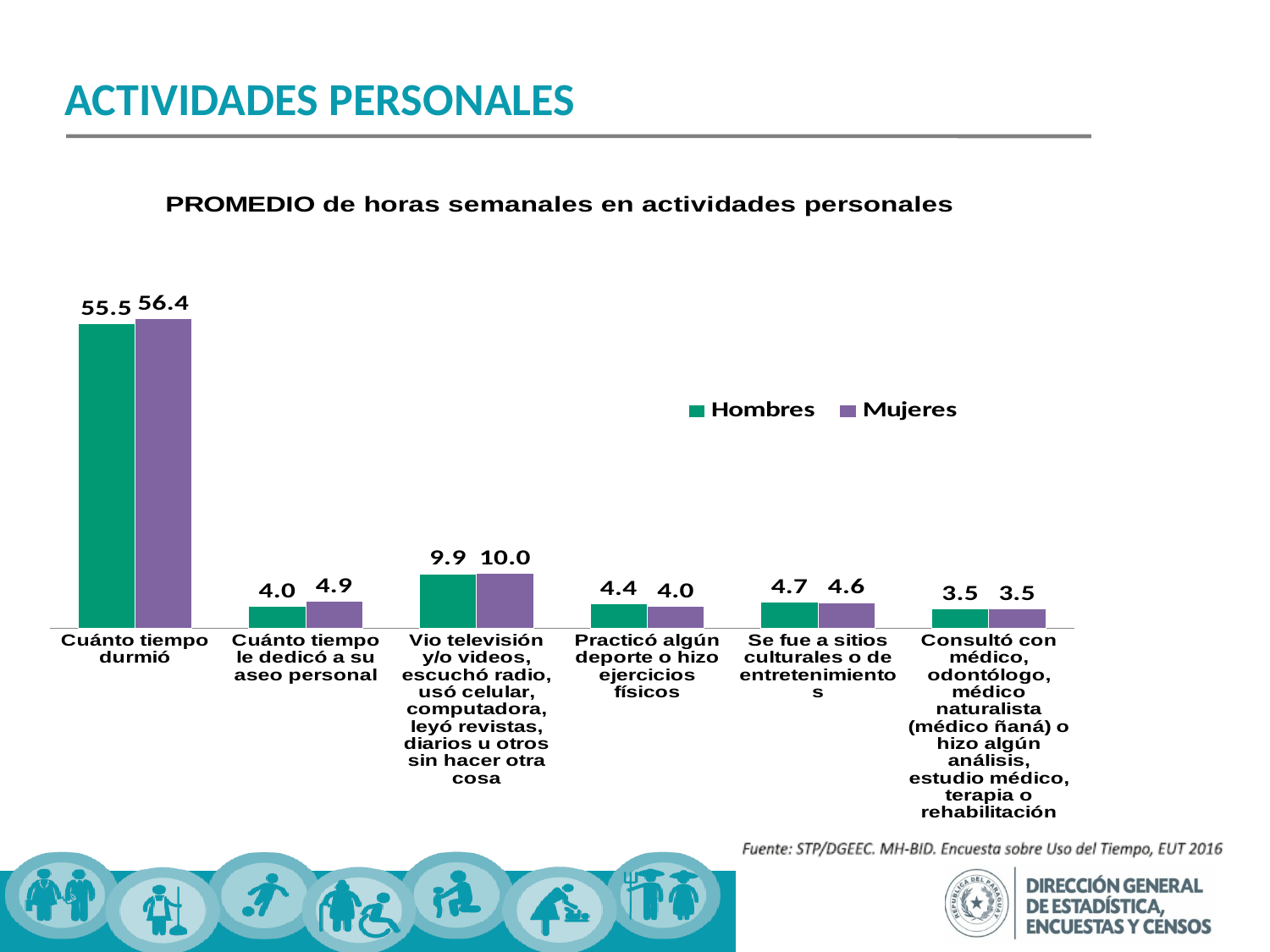
How many categories are shown on the x axis? 6 For 'Se fue a sitios culturales o de entretenimientos', which is larger, the Hombres value or the Mujeres value? Hombres What is the value for Hombres for 'Cuánto tiempo durmió'? 55.5 What is the difference between the Mujeres and Hombres values for 'Cuánto tiempo durmió'? 0.9 What is the value for Mujeres for 'Practicó algún deporte o hizo ejercicios físicos'? 4.0 What is the value for Mujeres for 'Cuánto tiempo le dedicó a su aseo personal'? 4.9 What is the difference between the Mujeres and Hombres values for 'Cuánto tiempo le dedicó a su aseo personal'? 0.9 How many series does the legend list? 2 What is the title of the chart? PROMEDIO de horas semanales en actividades personales Which category has the lowest value for Hombres? Consultó con médico, odontólogo, médico naturalista (médico ñaná) o hizo algún análisis, estudio médico, terapia o rehabilitación What kind of chart is shown on the slide? Bar chart Which category has the highest value for Mujeres? Cuánto tiempo durmió